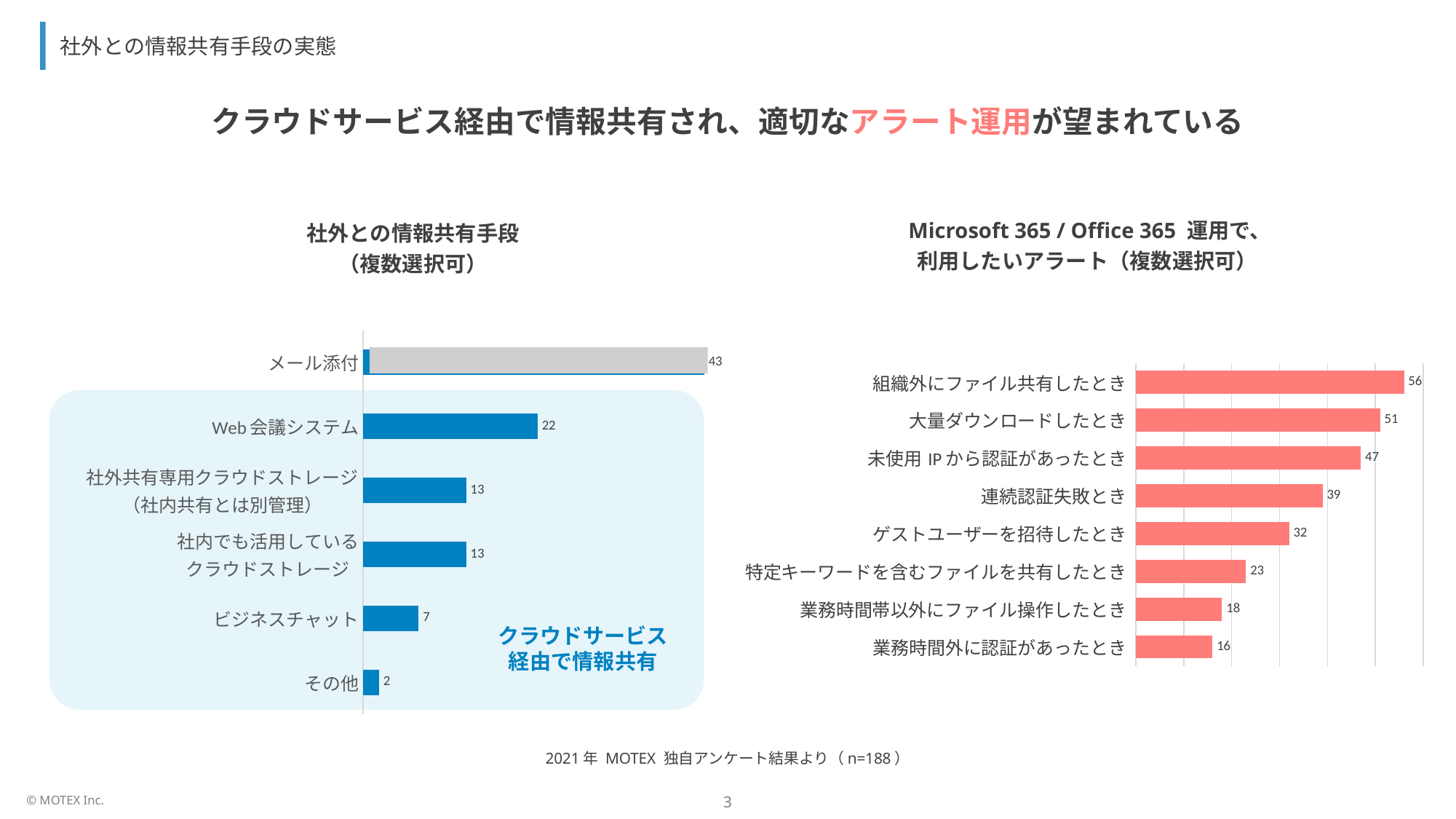
In the left chart (社外との情報共有手段), which category has the lowest value? その他 In the right chart (Microsoft 365 / Office 365 運用で、利用したいアラート), which category has the highest value? 組織外にファイル共有したとき In the left chart (社外との情報共有手段), what kind of chart is it? Bar chart In the left chart (社外との情報共有手段), what is the difference between メール添付 and Web会議システム? 21 In the left chart (社外との情報共有手段), what is the value for Web会議システム? 22 In the right chart (Microsoft 365 / Office 365 運用で、利用したいアラート), how many categories are shown? 8 In the right chart (Microsoft 365 / Office 365 運用で、利用したいアラート), what is the value for 大量ダウンロードしたとき? 51 In the right chart (Microsoft 365 / Office 365 運用で、利用したいアラート), what is the value for 業務時間外に認証があったとき? 16 In the right chart (Microsoft 365 / Office 365 運用で、利用したいアラート), what is the difference between 組織外にファイル共有したとき and 未使用IPから認証があったとき? 9 In the right chart (Microsoft 365 / Office 365 運用で、利用したいアラート), which is larger: 連続認証失敗とき or ゲストユーザーを招待したとき? 連続認証失敗とき In the left chart (社外との情報共有手段), what is the value for メール添付? 43 In the left chart (社外との情報共有手段), how many categories are shown? 6